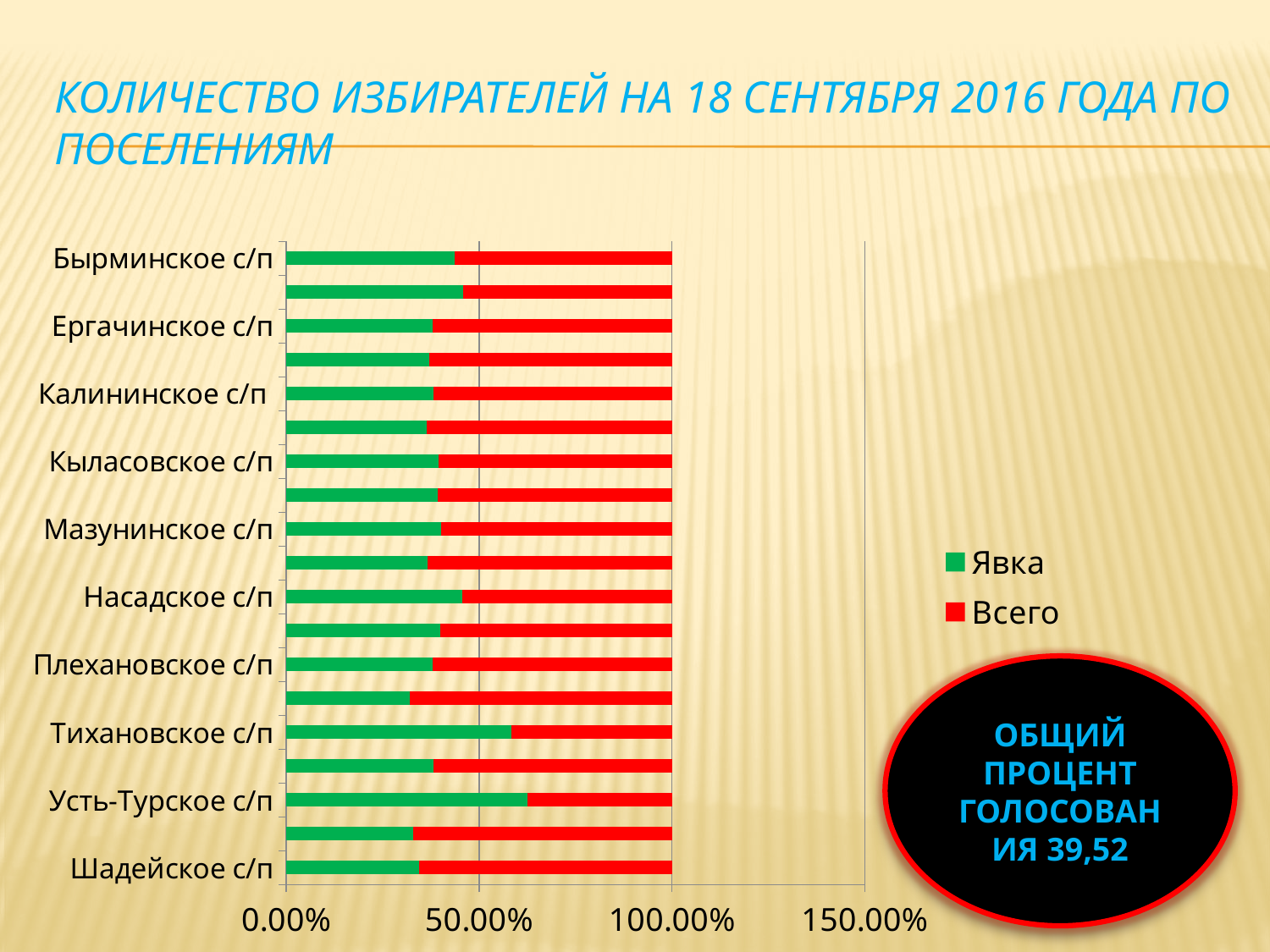
What kind of chart is shown on the slide? Stacked bar chart Is the Явка value for Усть-Турское с/п greater or less than 50.00%? greater What are the two series named in the legend? Явка and Всего Is the Явка value for Тихановское с/п greater or less than 50.00%? greater What is the total of the stacked bar for Шадейское с/п? 100.00% How many category labels are shown on the vertical axis? 10 Which colour represents the series Явка? Green Is the Явка value for Бырминское с/п greater or less than 50.00%? less Which has the larger Явка value, Тихановское с/п or Калининское с/п? Тихановское с/п Which has the larger Явка value, Усть-Турское с/п or Шадейское с/п? Усть-Турское с/п How many series does the legend list? 2